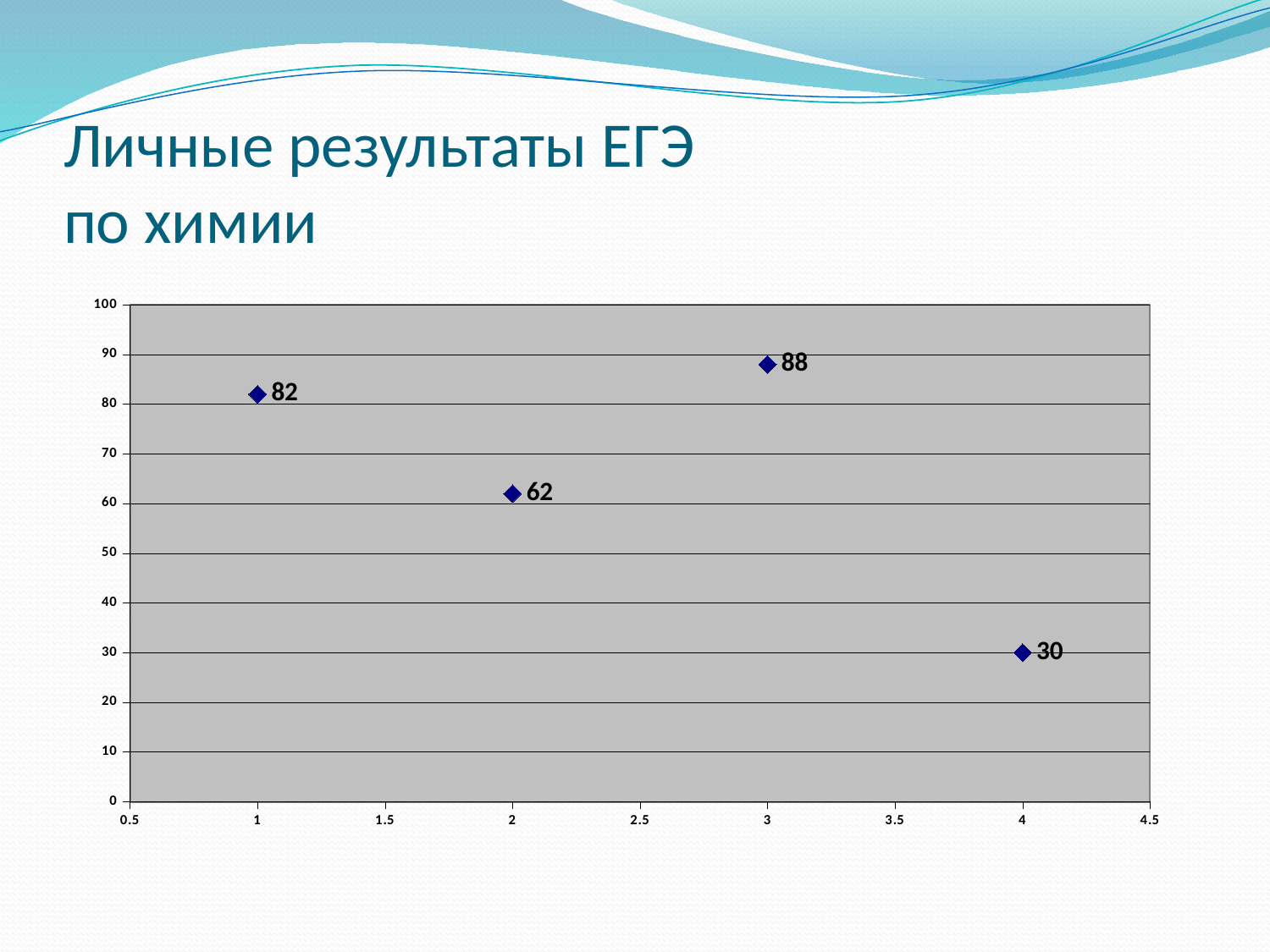
What kind of chart is shown on the slide? scatter chart What is the difference between the values at x = 1 and x = 2? 20 At which x value is the highest point plotted? 3 What is the value of the point at x = 4? 30 Which is larger, the value at x = 1 or the value at x = 3? x = 3 What is the difference between the values at x = 3 and x = 4? 58 At which x value is the lowest point plotted? 4 What is the value of the point at x = 2? 62 What is the maximum value shown on the vertical axis? 100 What is the value of the point at x = 1? 82 What is the value of the point at x = 3? 88 How many data points are plotted on the chart? 4